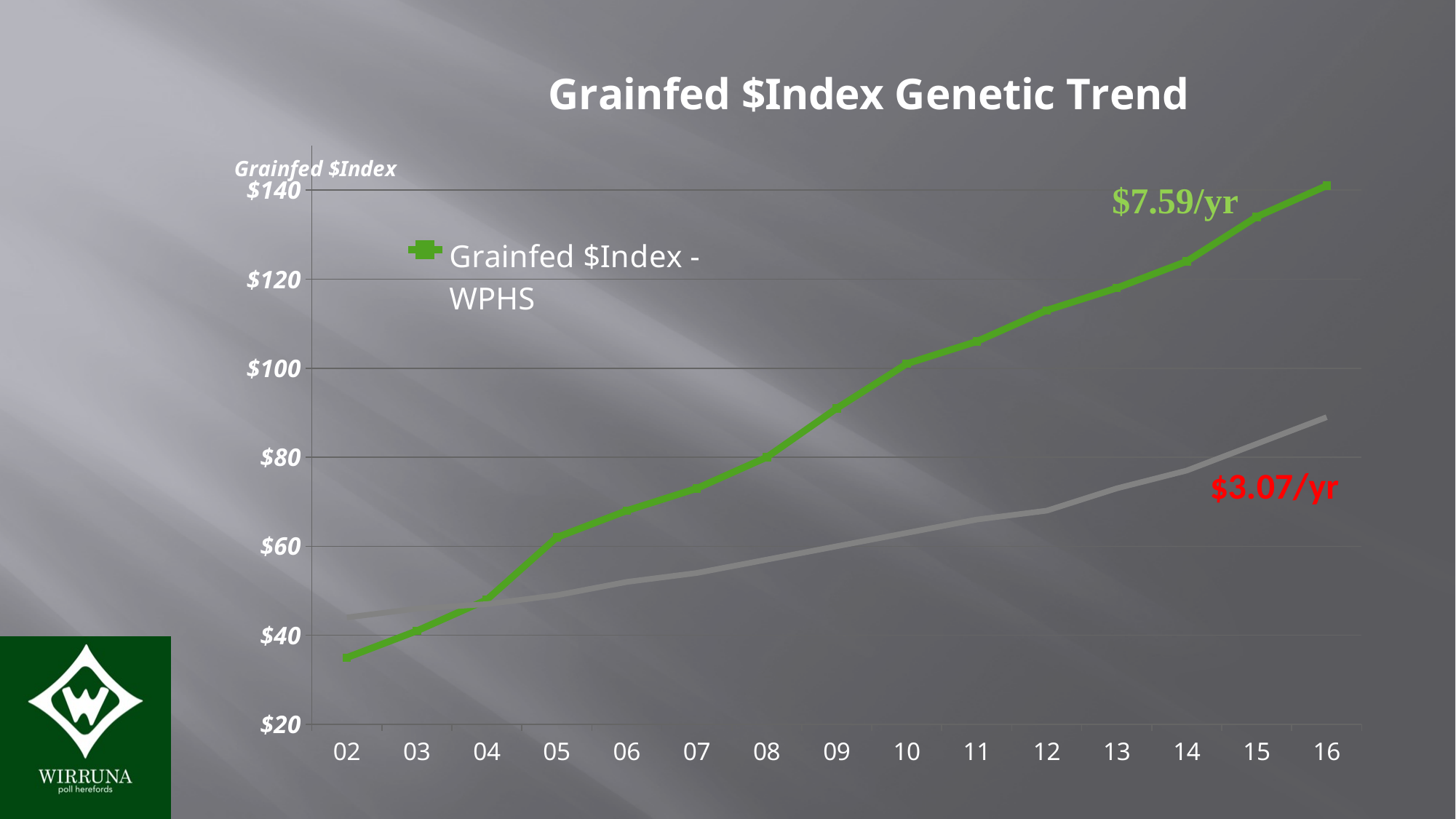
What is the title of the chart? Grainfed $Index Genetic Trend Is the value of the green Grainfed $Index - WPHS line at 14 greater or less than $120? greater Is the value of the green Grainfed $Index - WPHS line at 12 greater or less than $100? greater What is the series name shown in the legend? Grainfed $Index - WPHS How many years are shown along the x axis? 15 What kind of chart is shown on the slide? line chart Is the value of the green Grainfed $Index - WPHS line at 02 greater or less than $40? less At 02, which line has the higher value, the green Grainfed $Index - WPHS line or the grey line? the grey line How many series does the chart's legend list? 1 Does the green Grainfed $Index - WPHS line rise or fall from 02 to 16? rise At 16, which line has the higher value, the green Grainfed $Index - WPHS line or the grey line? the green Grainfed $Index - WPHS line